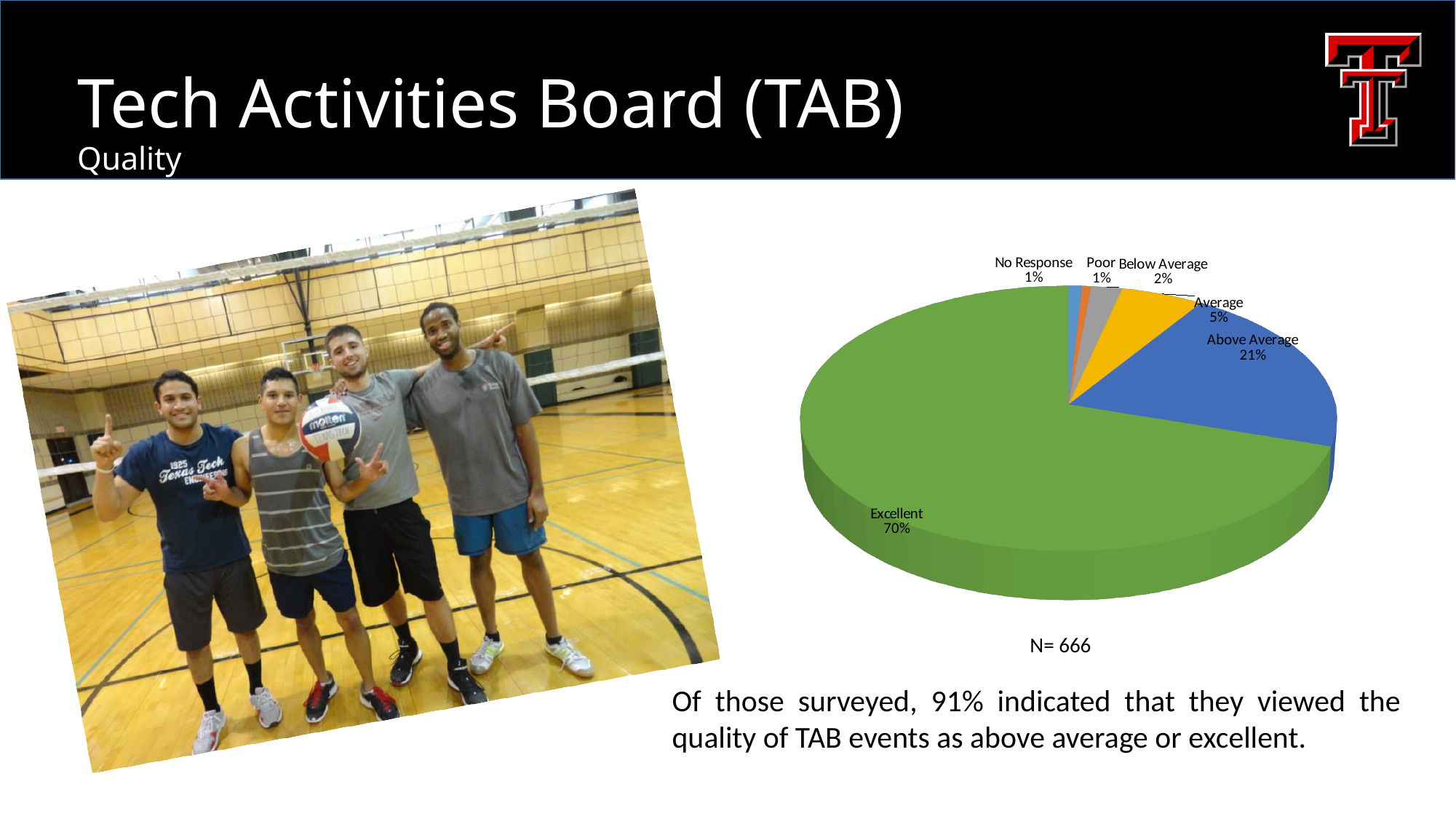
What is the combined share of the Excellent and Above Average slices? 91% What percentage of respondents rated the quality as Below Average? 2% Which is larger, the Average slice or the Below Average slice? Average What percentage of respondents rated the quality as Poor? 1% What kind of chart is shown on the slide? pie chart What is the sample size (N) shown below the chart? N= 666 What percentage of respondents rated the quality of TAB events as Excellent? 70% What percentage of respondents rated the quality as Above Average? 21% What percentage of respondents rated the quality as Average? 5% What is the difference in percentage points between the Excellent and Above Average slices? 49 How many categories are shown in the pie chart? 6 Which category has the largest share of the pie? Excellent